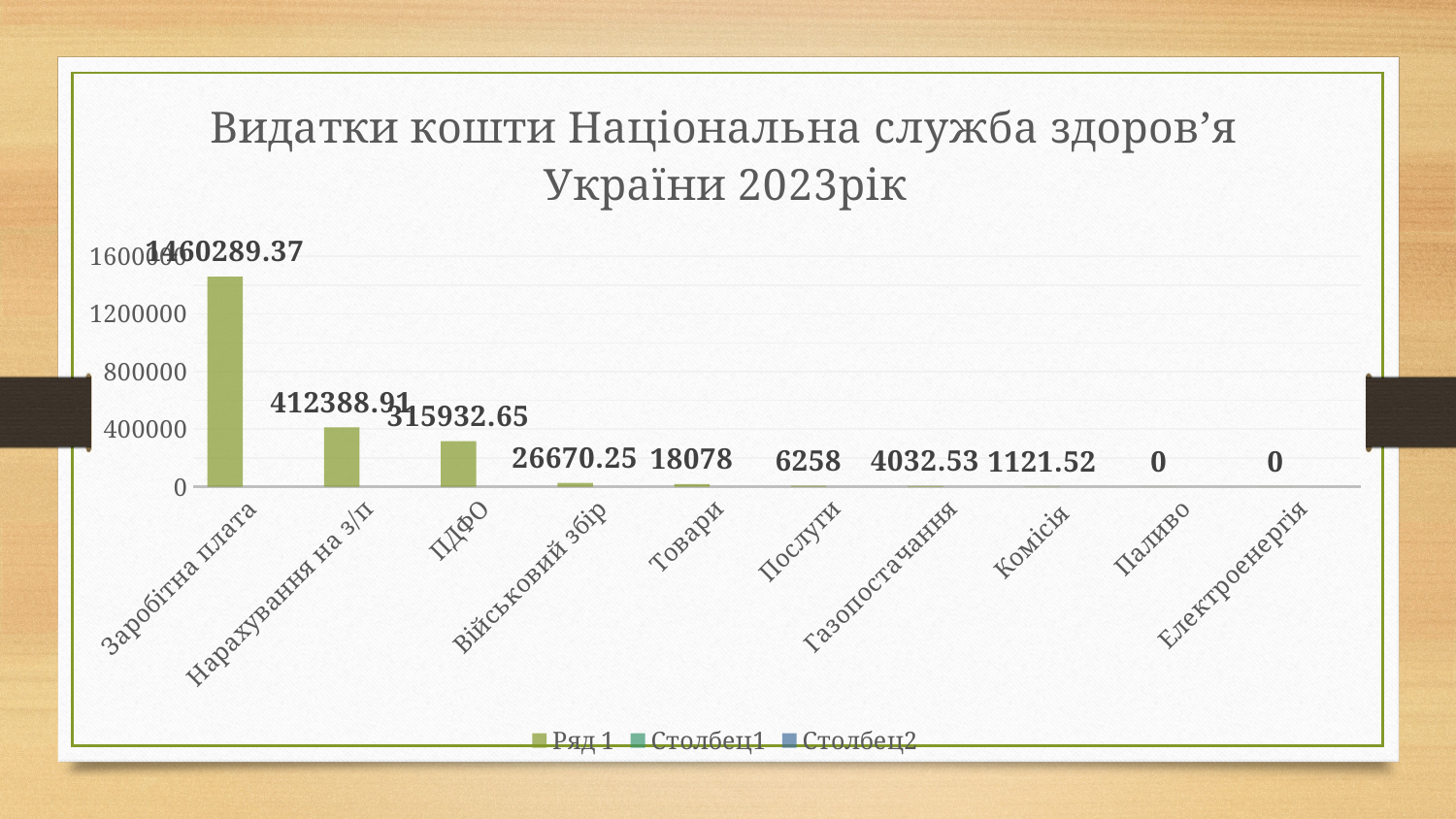
What is the difference between the values for Нарахування на з/п and ПДФО? 96456.26 How many categories are shown on the x axis? 10 Which categories have a value of 0? Паливо and Електроенергія What kind of chart is shown on the slide? bar chart Is the value for Заробітна плата greater or less than 1200000? greater What is the value for ПДФО? 315932.65 How many series does the legend list? 3 Which is larger, the value for Товари or the value for Послуги? Товари What is the value for Газопостачання? 4032.53 Which category has the highest value? Заробітна плата What is the value for Заробітна плата? 1460289.37 What is the value for Нарахування на з/п? 412388.91